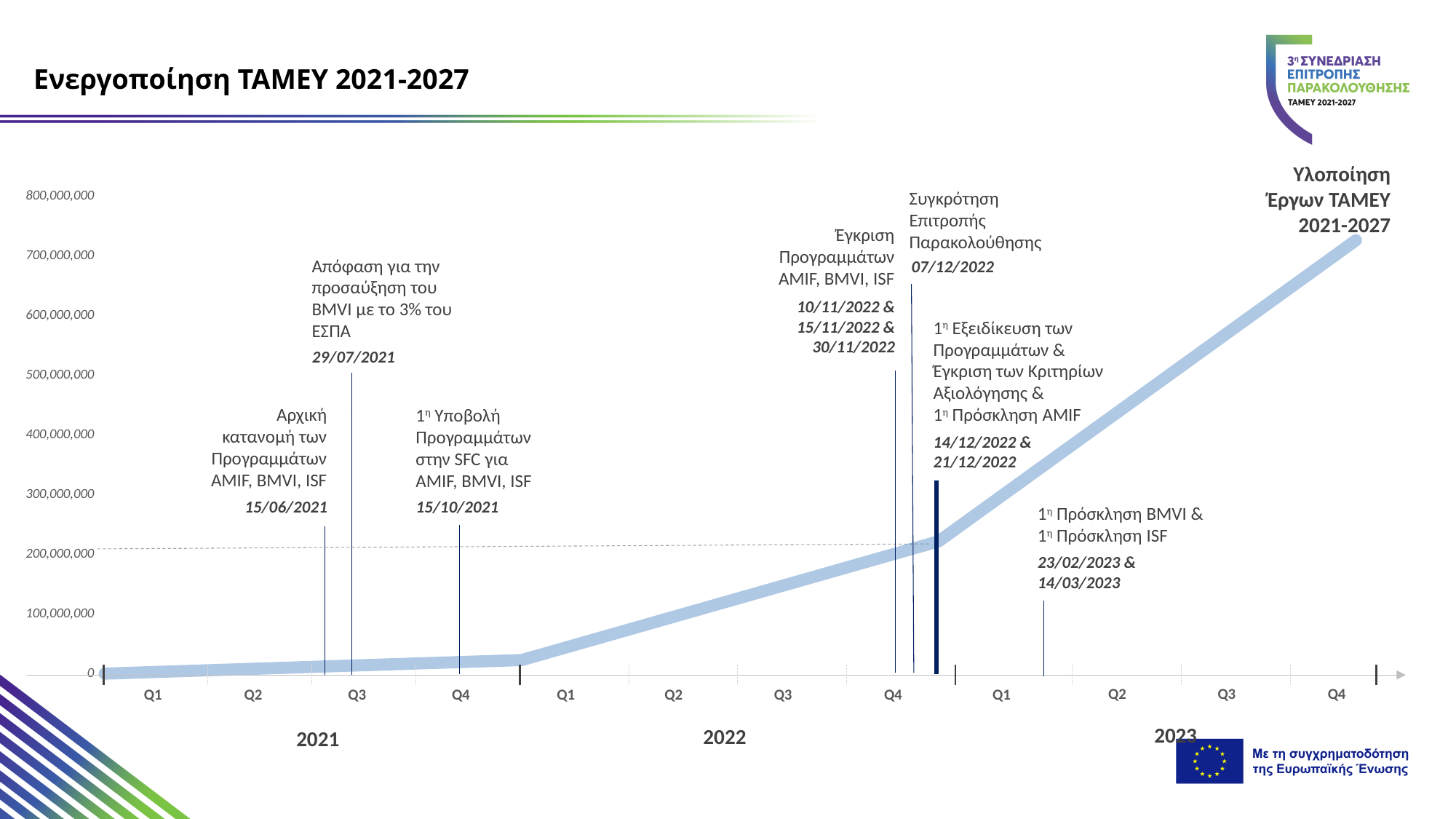
What kind of chart is shown on the slide? line chart What is the title of the slide? Ενεργοποίηση ΤΑΜΕΥ 2021-2027 Which is larger, the value at Q4 2022 or the value at Q4 2023? Q4 2023 Is the value at Q4 2021 greater or less than 100,000,000? less What is the highest value shown on the y axis? 800,000,000 Is the value at the end of Q4 2023 greater or less than 600,000,000? greater Is the value at Q2 2023 greater or less than 300,000,000? greater How many quarter labels are shown along the x axis? 12 How many years are labelled along the x axis? 3 Do the plotted values rise or fall from Q1 2021 to Q4 2023? rise